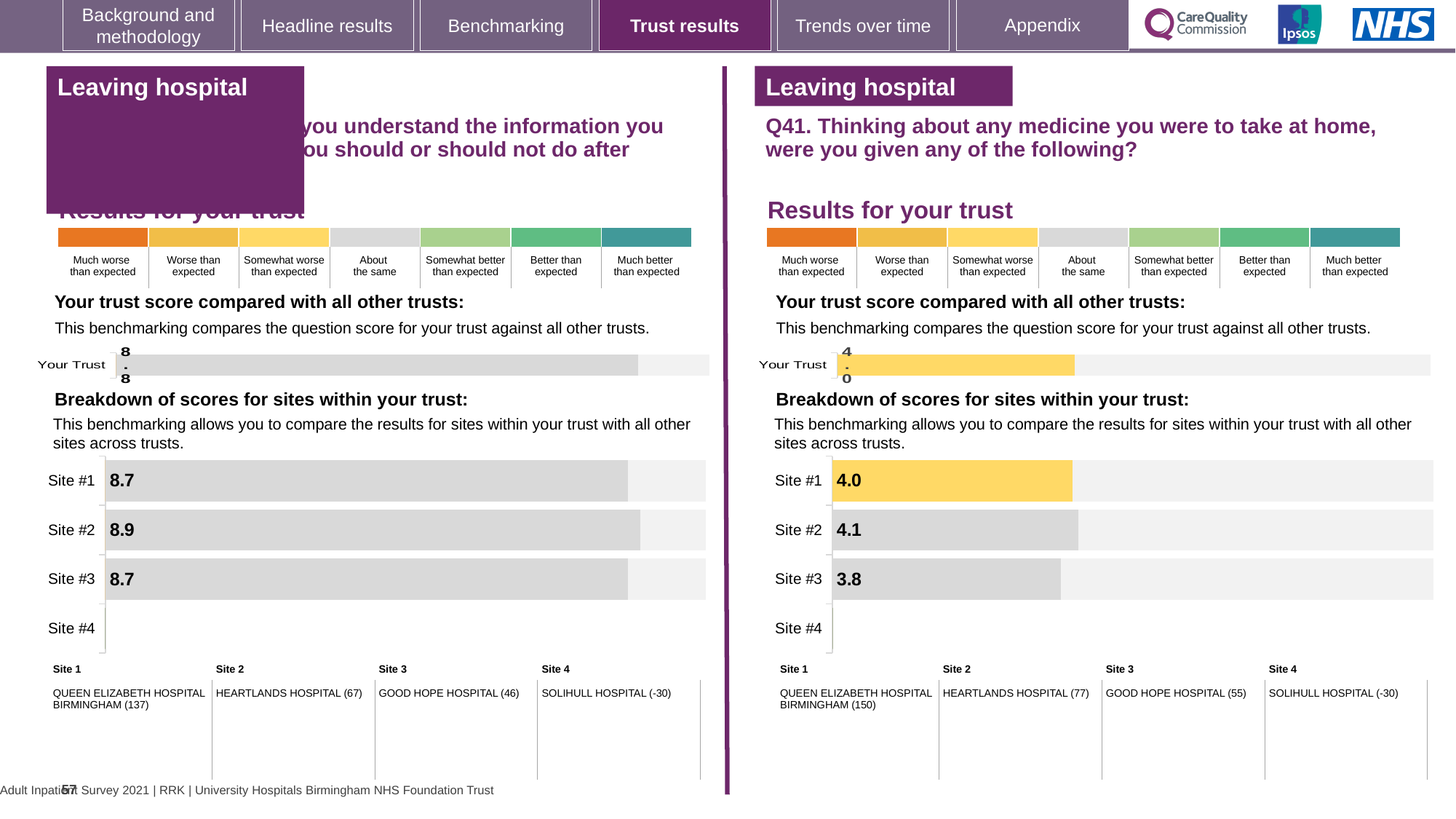
On the right-hand chart (Q41), which site has the lowest score among those with a bar? Site #3 What type of chart is used for the breakdown of scores for sites on the right-hand side? Bar chart On the left-hand chart, what is the 'Your Trust' score? 8.8 On the left-hand chart, what is the difference between the scores for Site #2 and Site #1? 0.2 On the left-hand chart, what is the score for Site #2? 8.9 On the right-hand chart (Q41), which site has the highest score? Site #2 On the right-hand chart (Q41), what is the 'Your Trust' score? 4.0 On the right-hand chart (Q41), what is the score for Site #1? 4.0 On the right-hand chart (Q41), what is the difference between the scores for Site #2 and Site #3? 0.3 On the left-hand chart, how many sites are listed in the breakdown of scores? 4 On the right-hand chart (Q41), what is the score for Site #3? 3.8 On the left-hand chart, which site has the highest score? Site #2